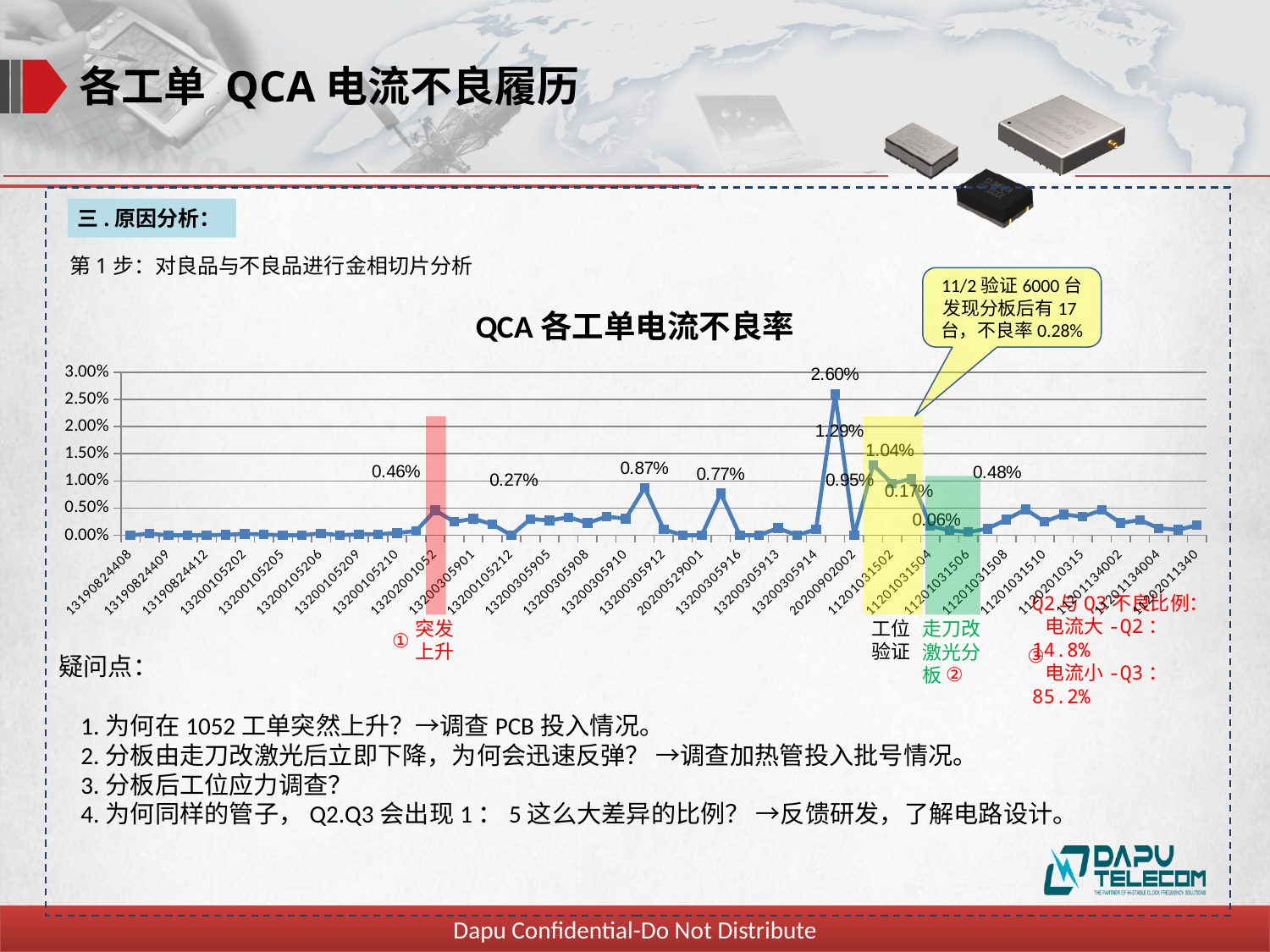
What is the title of the chart? QCA 各工单电流不良率 What is the highest data-labelled value on the chart? 2.60% Which is larger, the value labelled 0.87% or the value labelled 0.77%? 0.87% What is the lowest data-labelled value on the chart? 0.06% What is the maximum value shown on the y axis? 3.00% What is the data label on the point inside the green highlighted region? 0.06% What defect rate is stated in the callout box above the chart? 0.28% Is the highest point on the chart greater or less than 2.50%? greater What kind of chart is shown on the slide? line chart What is the difference between the 2.60% peak and the 1.29% value next to it? 1.31% What is the difference between the 1.04% value and the 0.17% value in the yellow highlighted region? 0.87% What is the data label on the point inside the red highlighted region? 0.46%